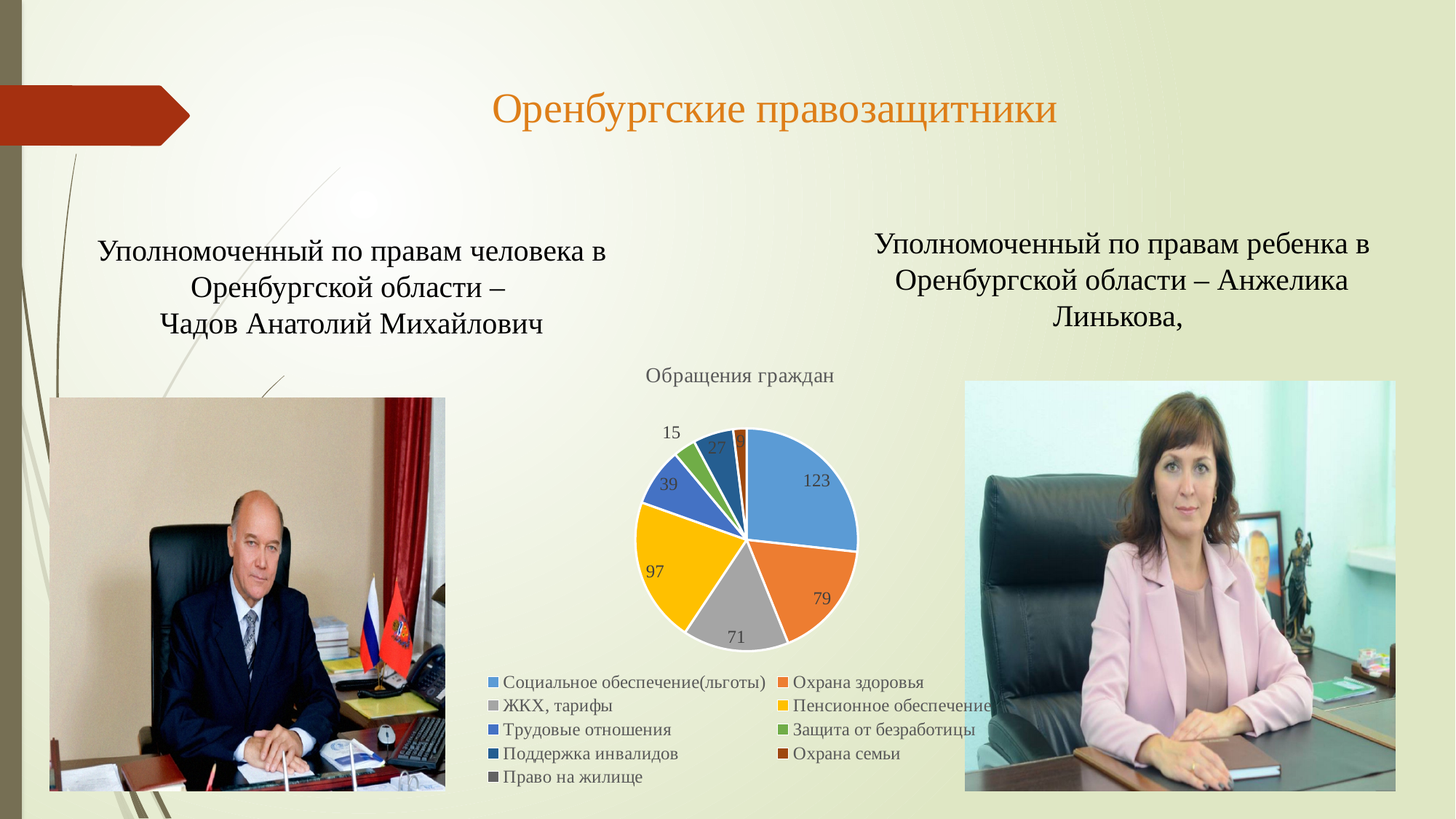
Which category has the largest slice in the pie chart? Социальное обеспечение(льготы) What is the difference between the values for "Социальное обеспечение(льготы)" and "Пенсионное обеспечение"? 26 What kind of chart is shown under the title "Обращения граждан"? pie chart What value is shown for "Социальное обеспечение(льготы)" in the pie chart? 123 What value is shown for "Трудовые отношения" in the pie chart? 39 What value is shown for "Охрана здоровья" in the pie chart? 79 What value is shown for "Пенсионное обеспечение" in the pie chart? 97 What value is shown for "Поддержка инвалидов" in the pie chart? 27 How many entries does the legend of the pie chart list? 9 Among the slices with a printed value, which category has the smallest value? Охрана семьи What value is shown for "ЖКХ, тарифы" in the pie chart? 71 What is the title of the pie chart? Обращения граждан